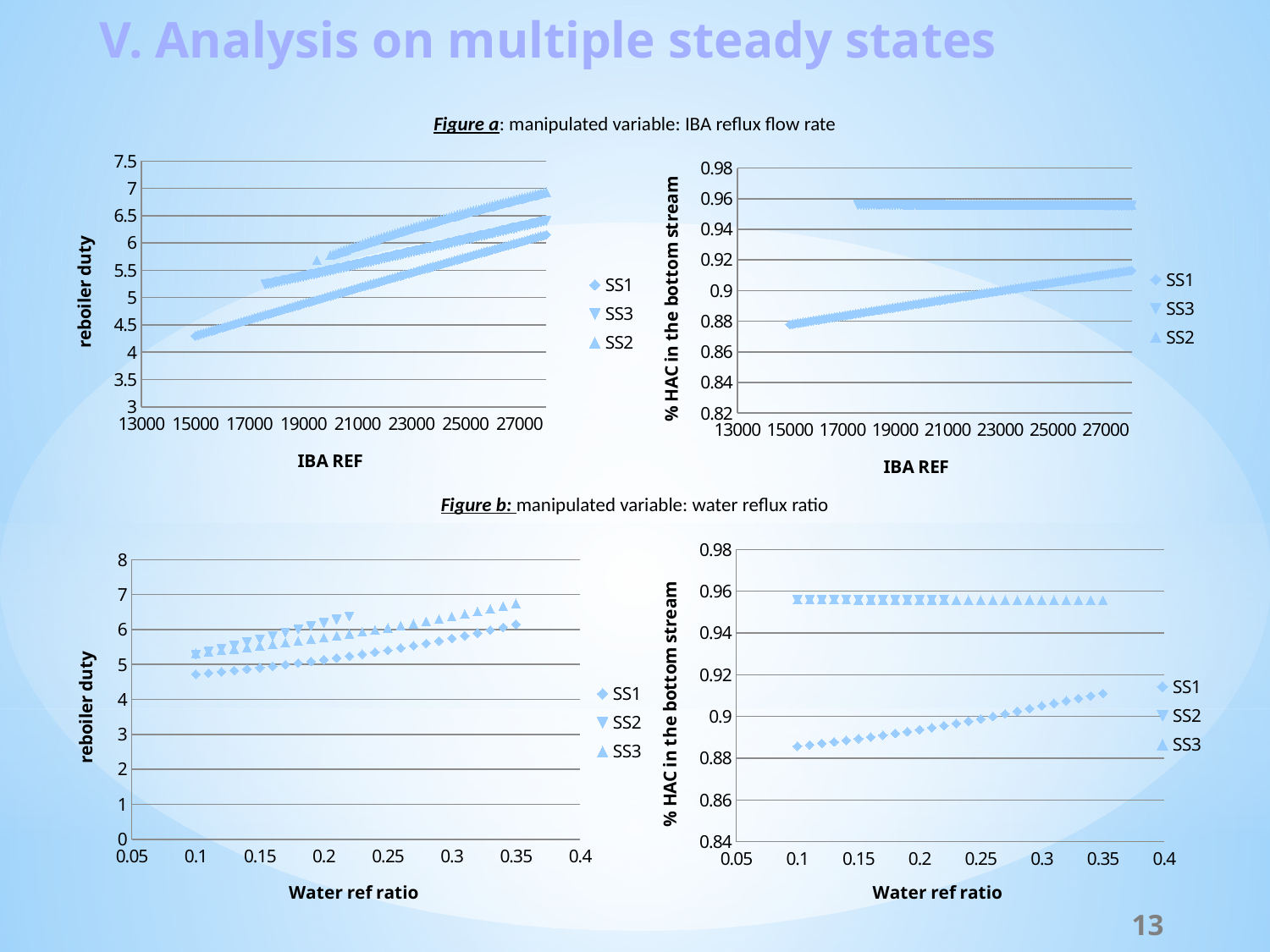
How many series does the legend of the top-left chart (reboiler duty vs IBA REF) list? 3 What is the y-axis title of the bottom-left chart (Water ref ratio on the x axis)? reboiler duty In the bottom-right chart (% HAC in the bottom stream vs Water ref ratio), does the lower series rise or fall as the water ref ratio increases? rise In the top-left chart (reboiler duty vs IBA REF), do the reboiler duty values rise or fall as IBA REF increases? rise What kind of chart is the top-left chart (reboiler duty vs IBA REF)? scatter chart In the top-right chart (% HAC in the bottom stream vs IBA REF), is the value of the lower series at an IBA REF of 15000 greater or less than 0.9? less In the top-right chart (% HAC in the bottom stream vs IBA REF), is the value of the upper series greater or less than 0.94? greater What is the x-axis title of the top-right chart (% HAC in the bottom stream)? IBA REF How many series does the legend of the bottom-right chart (% HAC in the bottom stream vs Water ref ratio) list? 3 In the bottom-right chart (% HAC in the bottom stream vs Water ref ratio), is the value of the lower series at a water ref ratio of 0.1 greater or less than 0.9? less